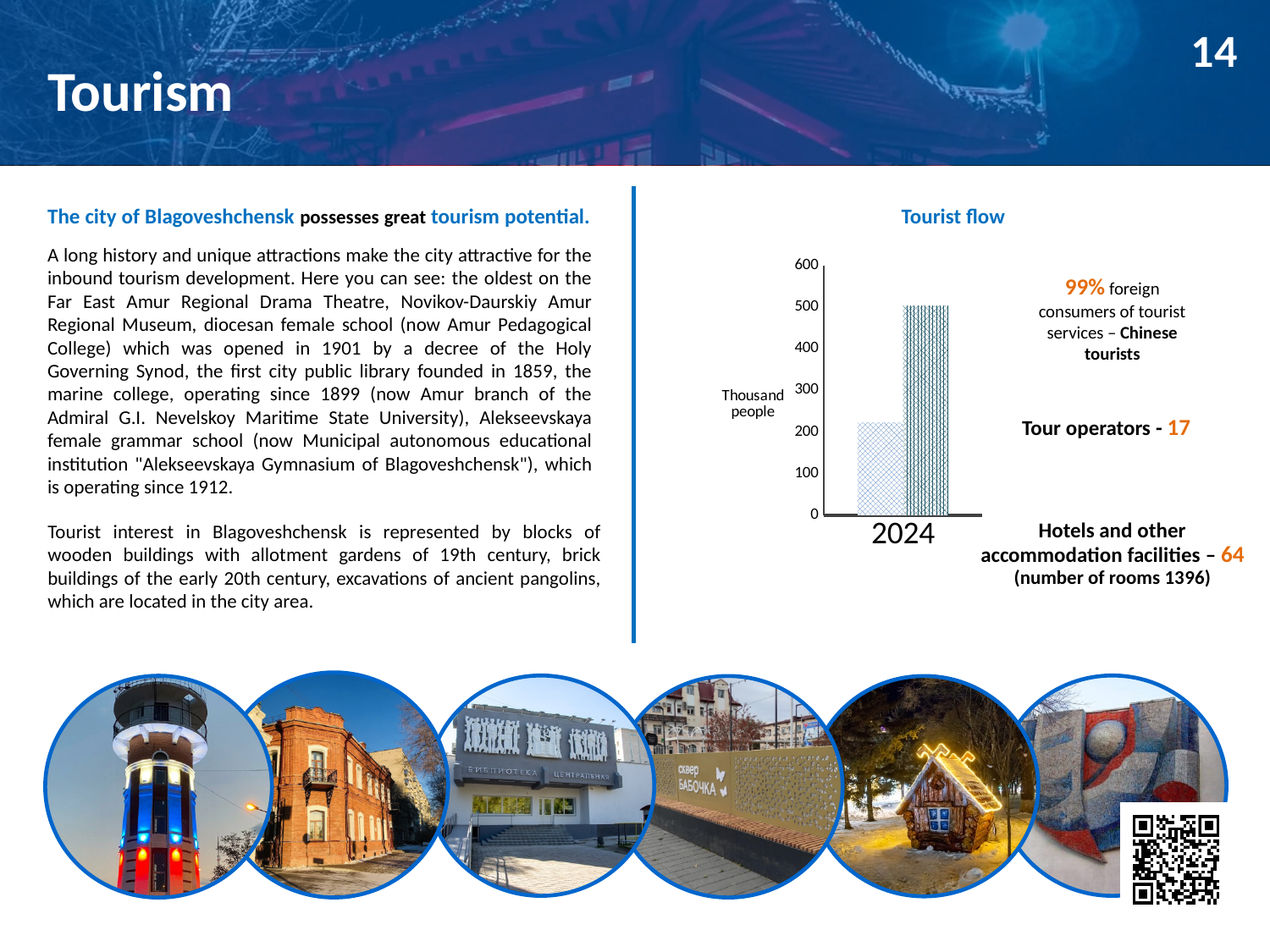
How many bars are plotted in the "Tourist flow" chart? 2 In the "Tourist flow" chart, is the value of the right (hatched) bar greater or less than 400? greater What kind of chart is the "Tourist flow" chart? bar chart Which year is shown on the x axis of the "Tourist flow" chart? 2024 What is the title of the chart on the slide? Tourist flow In the "Tourist flow" chart, which bar is taller, the left dotted bar or the right hatched bar? the right hatched bar What is the highest value shown on the vertical axis of the "Tourist flow" chart? 600 In the "Tourist flow" chart, is the value of the left (dotted) bar greater or less than 300? less What is the label on the vertical axis of the "Tourist flow" chart? Thousand people How many categories are shown on the x axis of the "Tourist flow" chart? 1